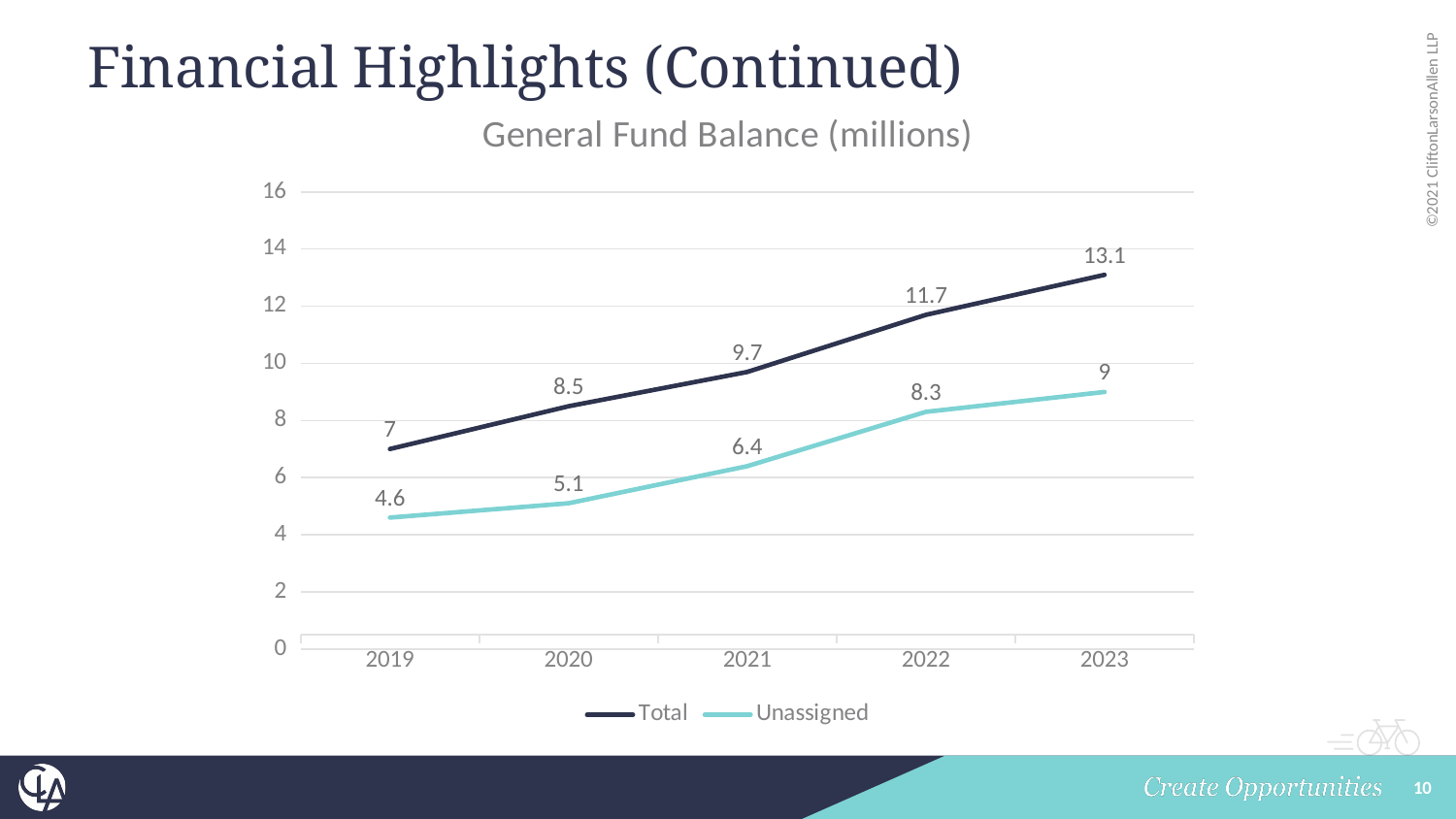
What is the Unassigned general fund balance in 2020? 5.1 What is the Total general fund balance in 2021? 9.7 Which is larger, the Total fund balance in 2020 or the Unassigned fund balance in 2023? Unassigned fund balance in 2023 How many series does the legend list? 2 Does the Total fund balance rise or fall from 2019 to 2023? rise What is the Total general fund balance in 2023? 13.1 What is the difference between the Total and Unassigned fund balance in 2022? 3.4 How many years are shown on the x axis? 5 What kind of chart is shown on the slide? line chart Is the Unassigned fund balance in 2021 greater or less than 8? less In which year is the Total fund balance lowest? 2019 In which year is the Unassigned fund balance highest? 2023